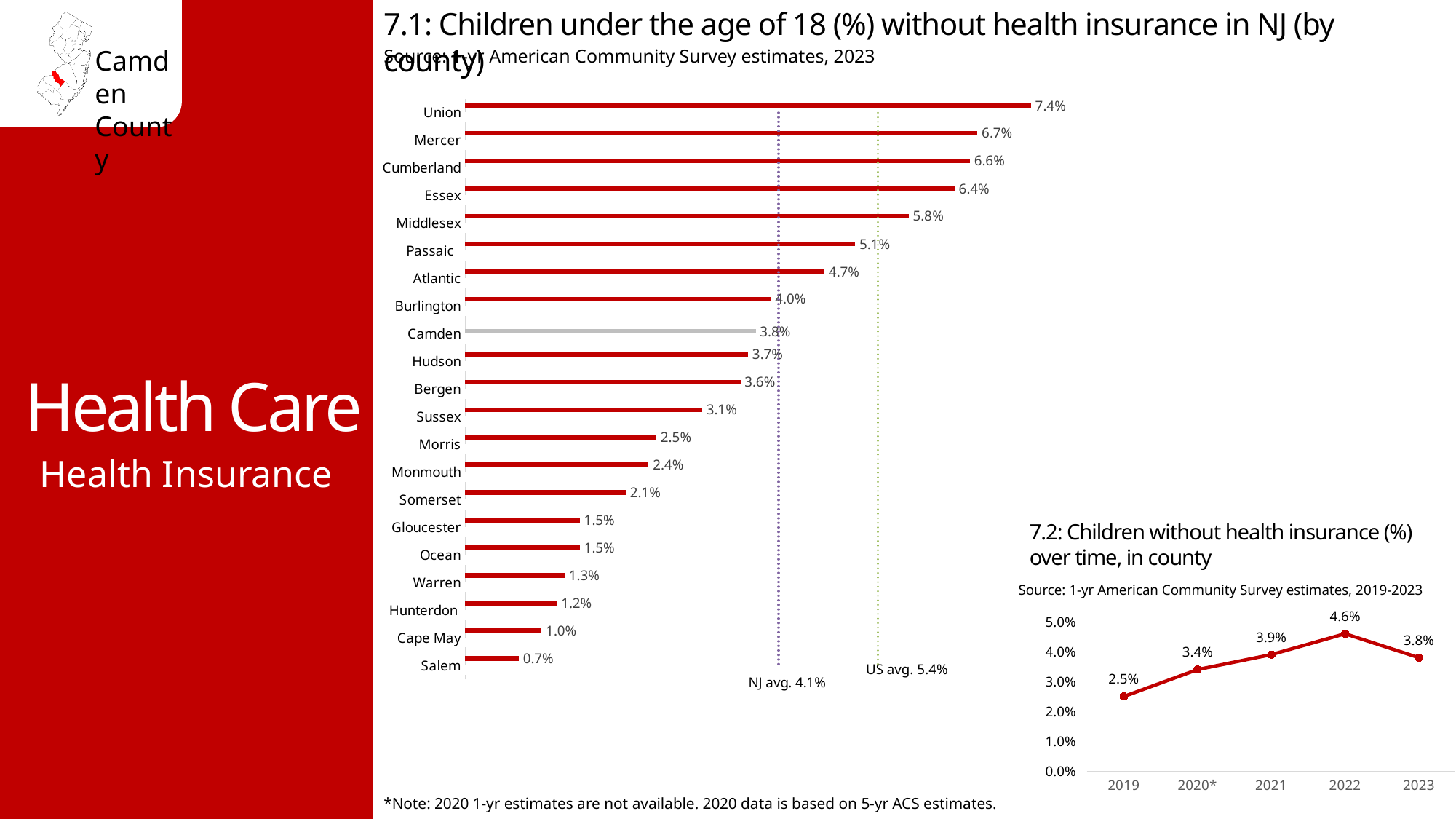
In chart 7.2, what is the difference between the 2022 and 2023 values? 0.8% In chart 7.1, what NJ average is marked by the dotted reference line? 4.1% In chart 7.1, which county has a larger value, Essex or Middlesex? Essex In chart 7.1, which county has the highest percentage of children without health insurance? Union In chart 7.2, what is the value for 2022? 4.6% In chart 7.1, what is the difference between the values for Union and Salem? 6.7% In chart 7.1, how many counties are shown? 21 In chart 7.2, which year has the lowest value? 2019 In chart 7.1, what is the value for Passaic? 5.1% What kind of chart is chart 7.2 (children without health insurance over time)? Line chart In chart 7.1 (children under 18 without health insurance by county), what is the value for Camden? 3.8% In chart 7.1, which county has the lowest percentage of children without health insurance? Salem